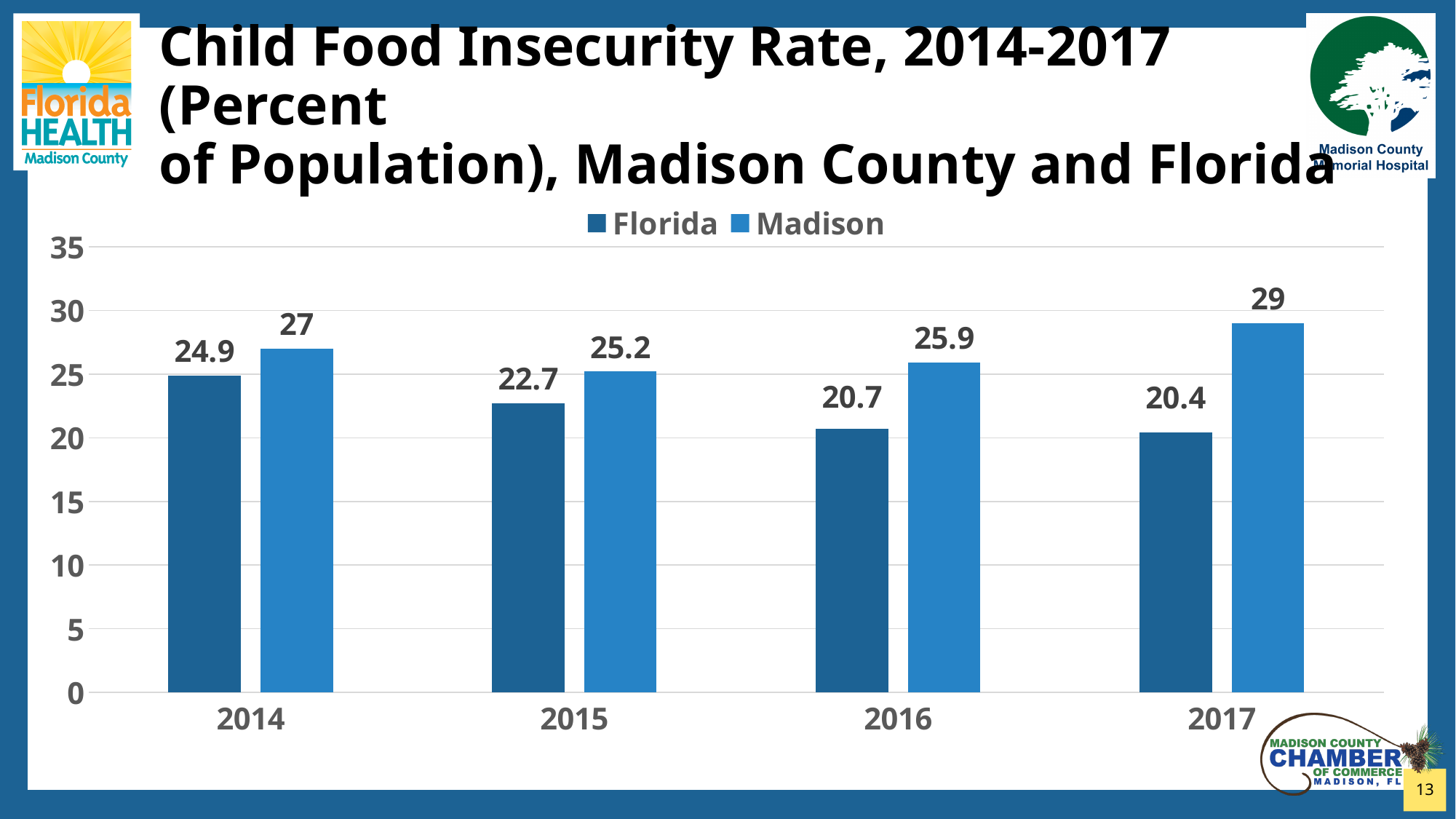
How many years are shown on the x axis? 4 What kind of chart is shown on the slide? bar chart Which is larger in 2016, the Florida value or the Madison value? Madison What is the difference between the Madison and Florida values in 2017? 8.6 What is the difference between the Madison and Florida values in 2014? 2.1 In which year is the Florida value lowest? 2017 What is the child food insecurity rate for Madison in 2017? 29 How many series does the legend list? 2 In which year is the Madison value highest? 2017 What is the child food insecurity rate for Florida in 2014? 24.9 What is the value for Madison in 2015? 25.2 Is the Florida value for 2016 greater or less than 25? less